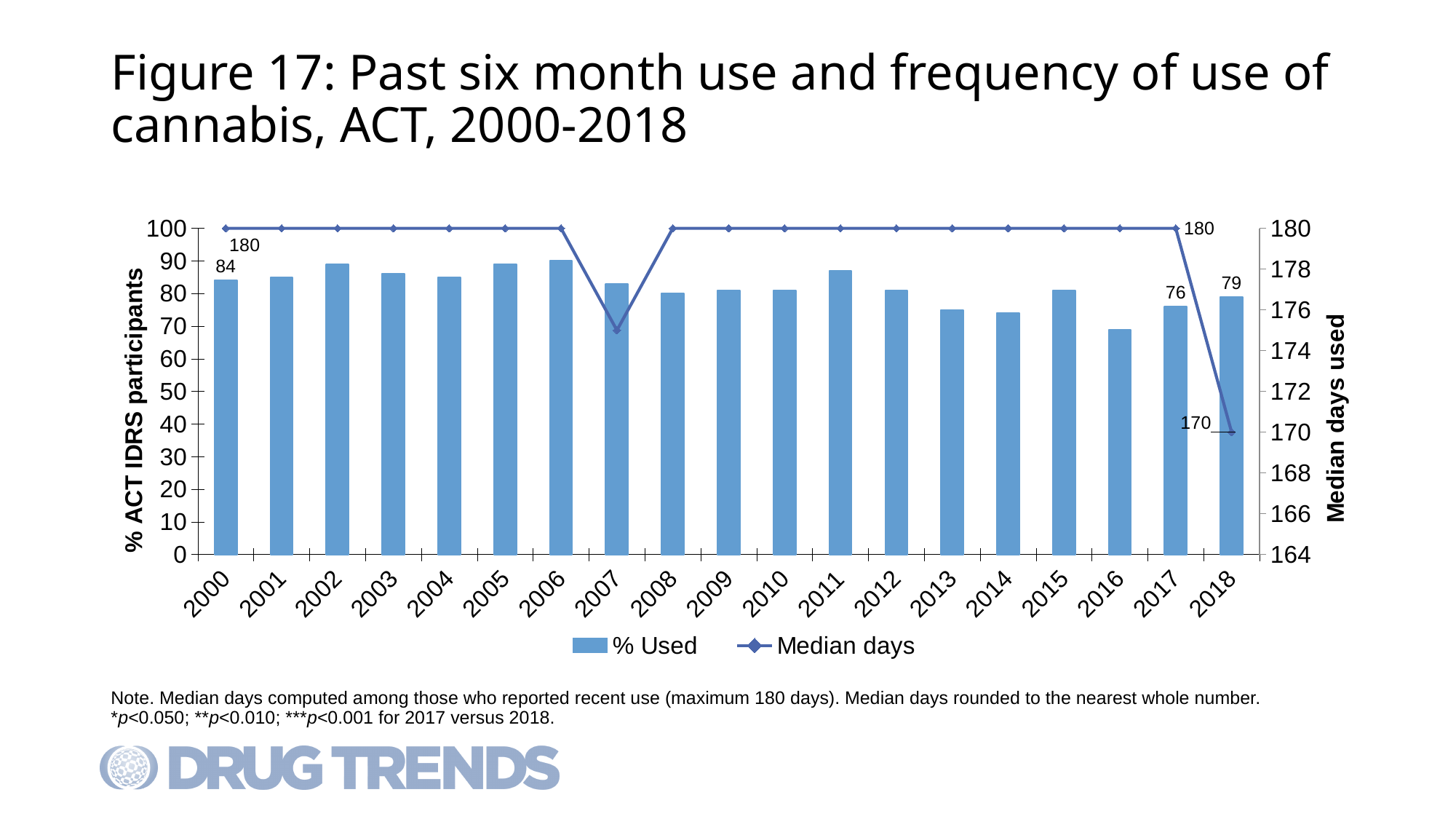
What is the Median days value for 2017? 180 Which year has the higher % Used, 2017 or 2018? 2018 What is the % Used value for 2017? 76 What is the Median days value for 2018? 170 What is the difference in Median days between 2017 and 2018? 10 What is the % Used value for 2000? 84 Which year has the lowest Median days value? 2018 How many series does the legend list? 2 What is the % Used value for 2018? 79 By how much did % Used change from 2017 to 2018? 3 Which year has the lowest % Used bar? 2016